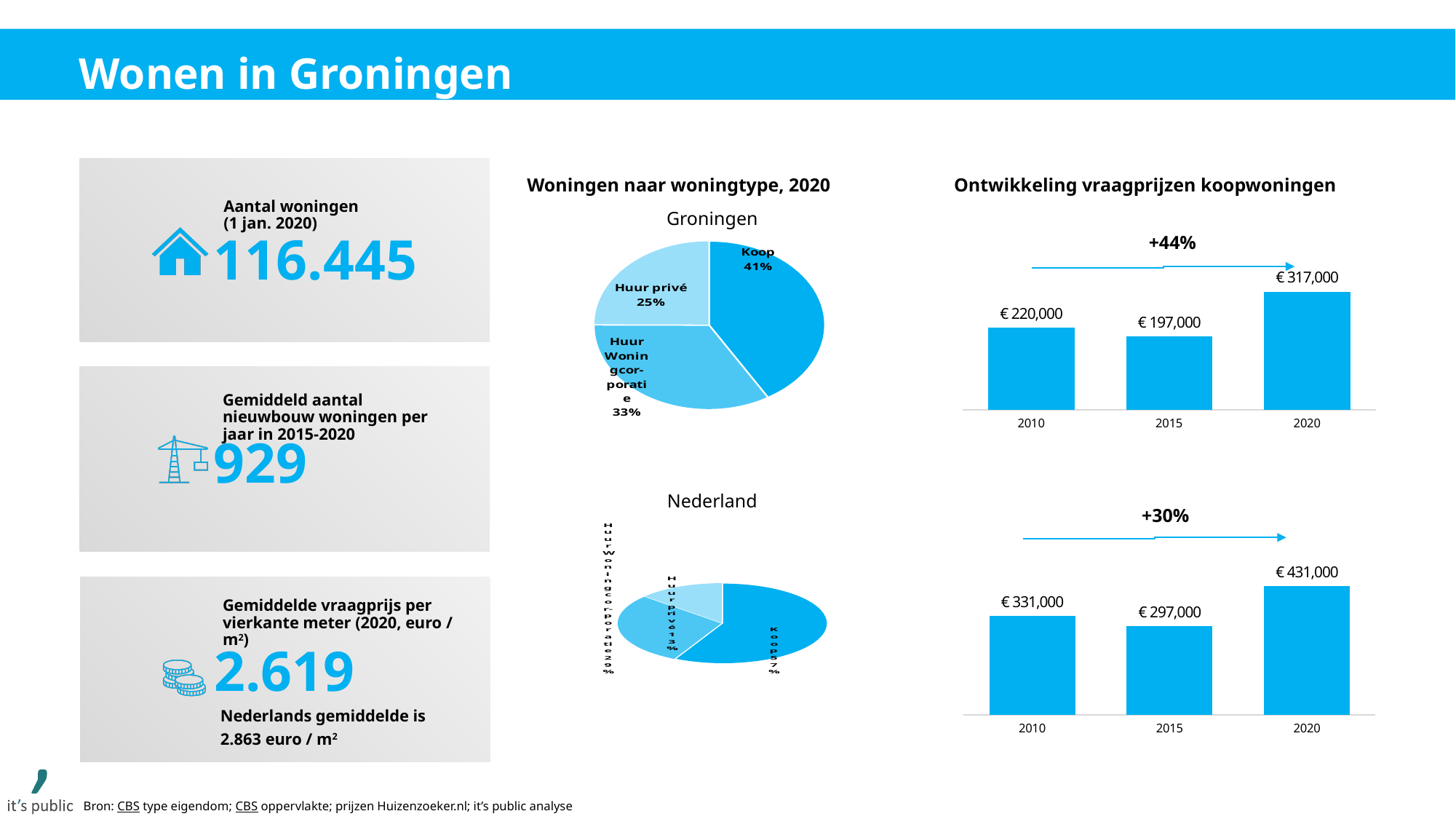
In the Nederland pie chart, what share of homes is Koop? 57% How many slices does the Groningen pie chart have? 3 In the Groningen pie chart, which category has the largest share? Koop In the top bar chart under 'Ontwikkeling vraagprijzen koopwoningen', what is the value for 2020? € 317,000 In the top bar chart under 'Ontwikkeling vraagprijzen koopwoningen', which year has the lowest value? 2015 In the bottom bar chart under 'Ontwikkeling vraagprijzen koopwoningen', which is larger, the value for 2015 or 2020? 2020 In the Groningen pie chart, which category has the smallest share? Huur privé In the Groningen pie chart, what share of homes is Koop? 41% What type of chart is used to show 'Ontwikkeling vraagprijzen koopwoningen'? Bar chart In the bottom bar chart under 'Ontwikkeling vraagprijzen koopwoningen', what is the value for 2010? € 331,000 In the Groningen pie chart, what share of homes is Huur privé? 25% In the top bar chart under 'Ontwikkeling vraagprijzen koopwoningen', what is the difference between the 2020 and 2010 values? € 97,000